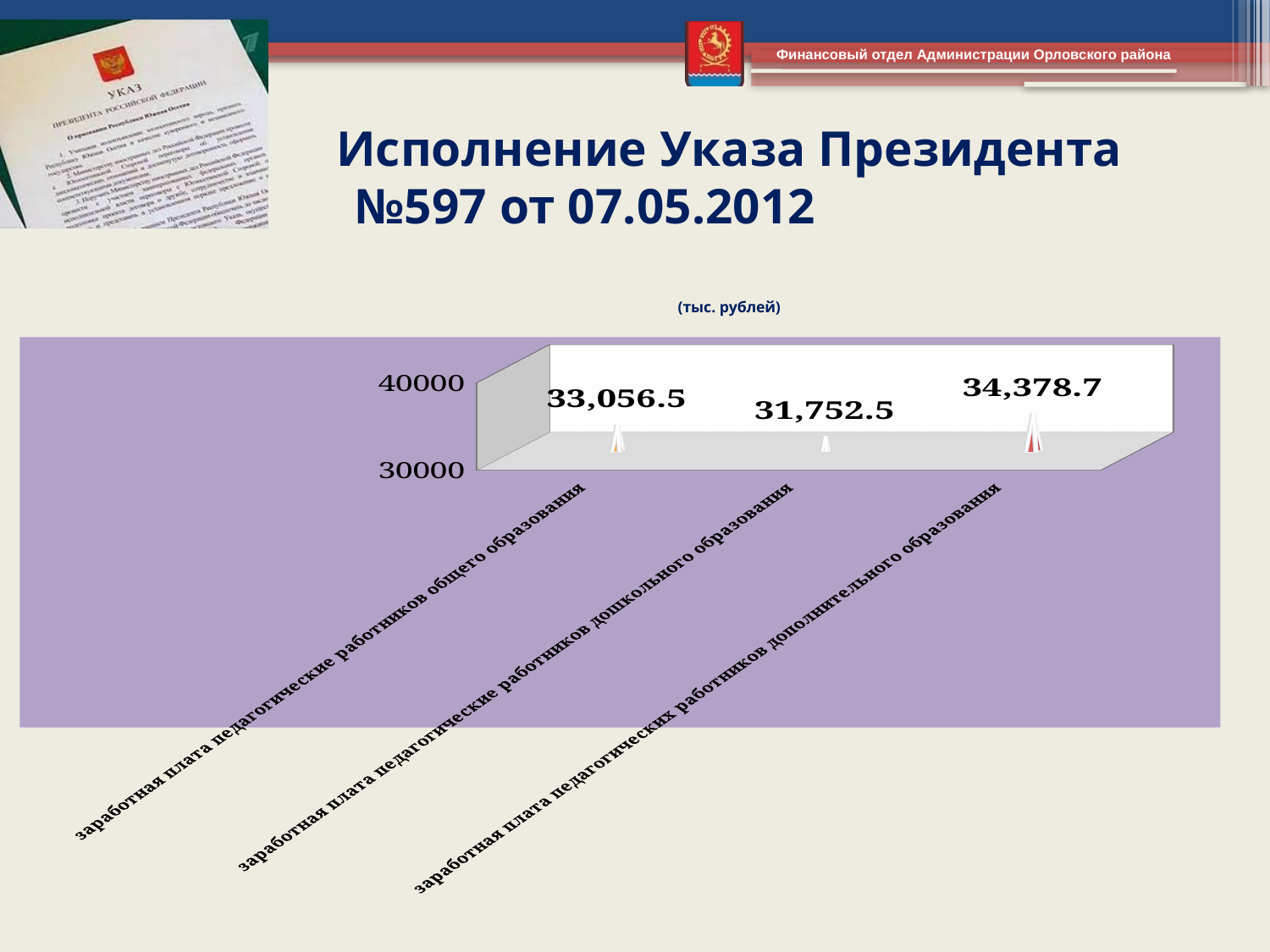
What kind of chart is shown on the slide? bar chart How many categories are shown in the chart? 3 What is the value for заработная плата педагогические работников дошкольного образования? 31,752.5 In what units are the chart values given? тыс. рублей What is the difference between the values for общего образования and дошкольного образования? 1,304.0 Which is larger: the value for общего образования or the value for дополнительного образования? дополнительного образования What is the value for заработная плата педагогические работников общего образования? 33,056.5 Which category has the lowest value? заработная плата педагогические работников дошкольного образования What is the difference between the values for дополнительного образования and дошкольного образования? 2,626.2 Which category has the highest value? заработная плата педагогических работников дополнительного образования Is the value for дошкольного образования greater or less than 30000? greater What is the value for заработная плата педагогических работников дополнительного образования? 34,378.7